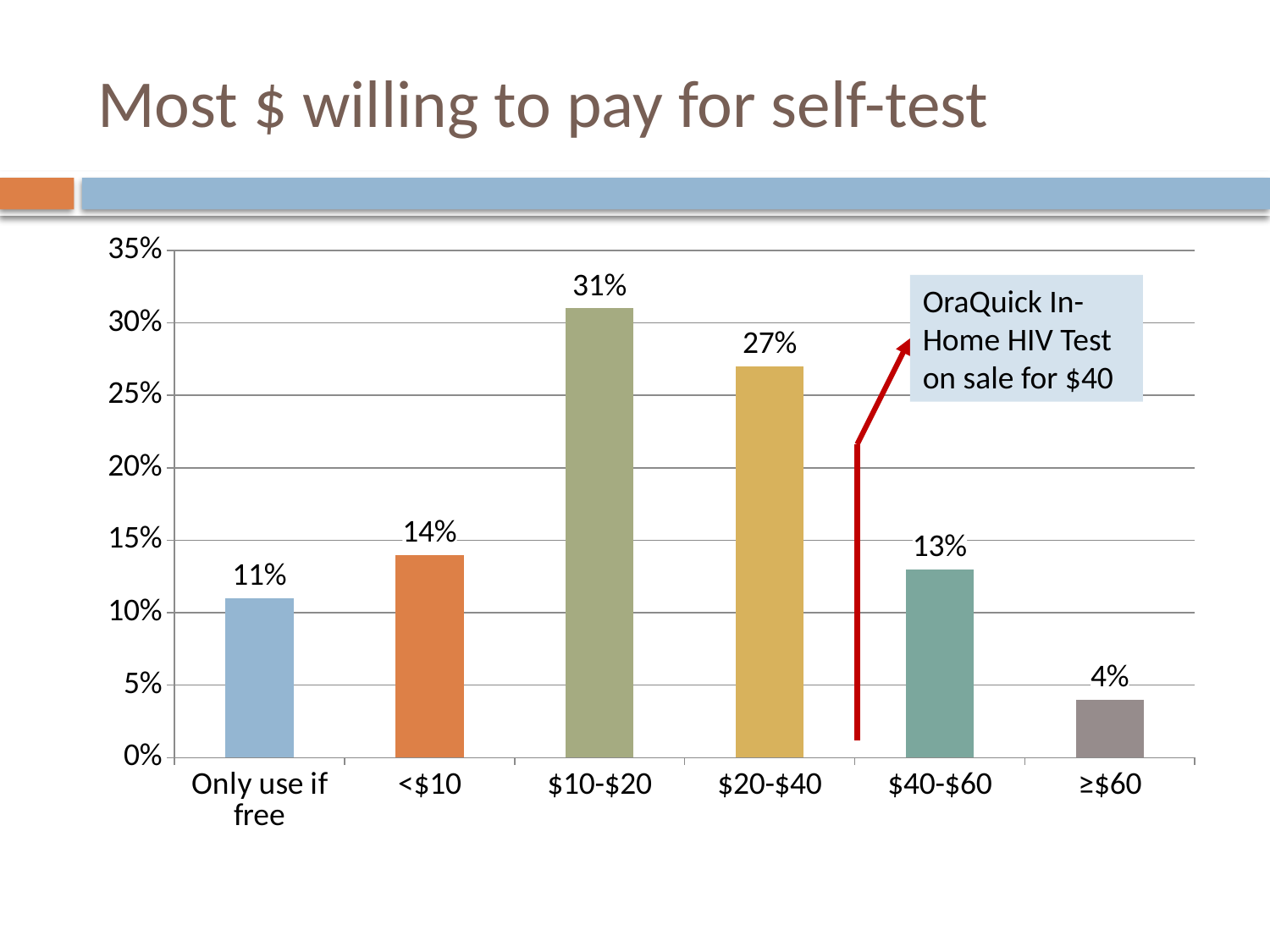
According to the callout box, what is the OraQuick In-Home HIV Test on sale for? $40 What is the value for the $10-$20 category? 31% What is the title of the slide? Most $ willing to pay for self-test Which category has the highest value? $10-$20 What percentage of respondents would only use the self-test if free? 11% What kind of chart is shown on the slide? Bar chart Which is larger, the value for <$10 or the value for $40-$60? <$10 Which category has the lowest value? ≥$60 How many categories are shown on the x axis? 6 What is the value for the $40-$60 category? 13% What is the difference between the $10-$20 and $20-$40 values? 4% Is the value for $20-$40 greater or less than 25%? greater